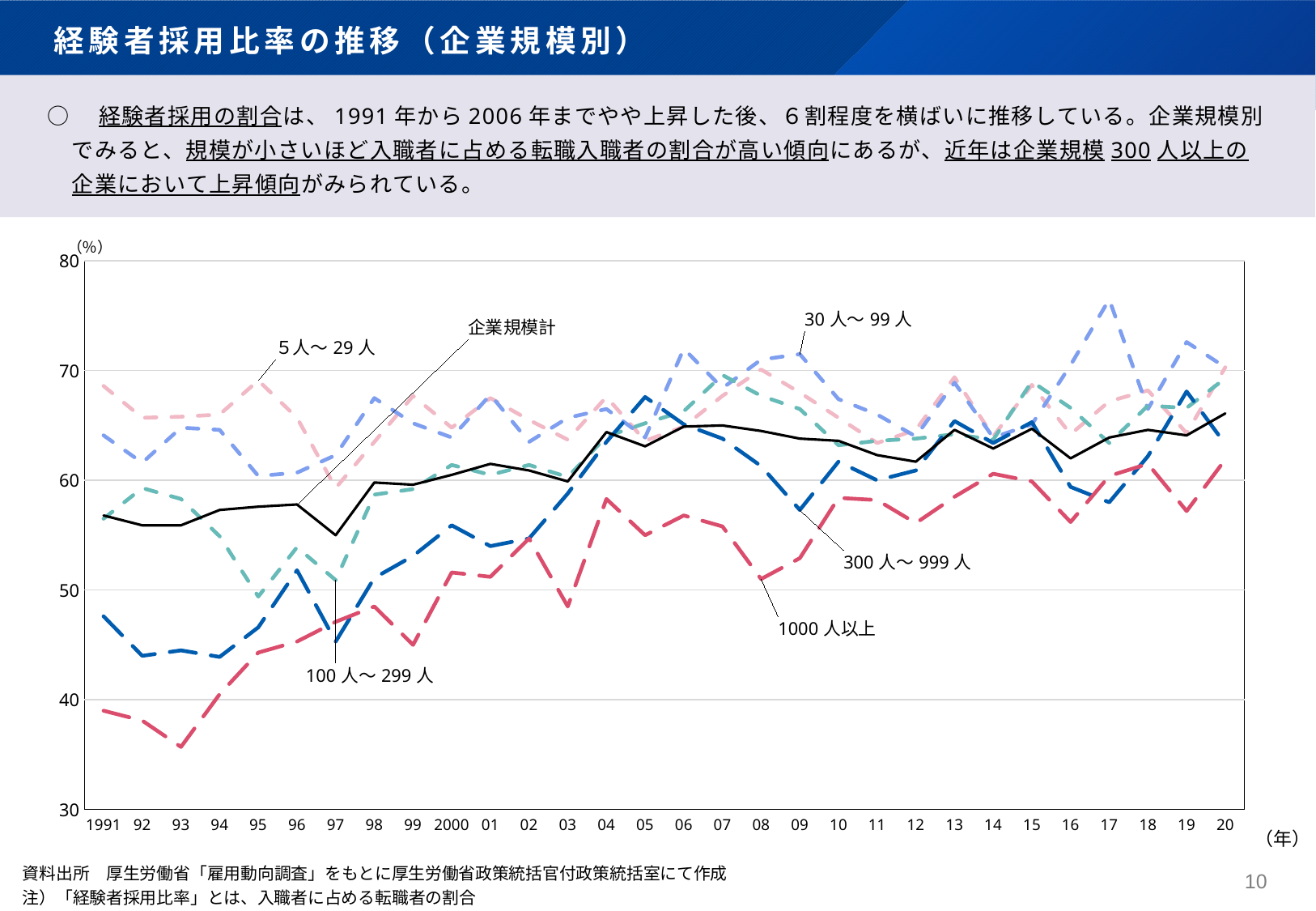
What kind of chart is shown on the slide? line chart Is the value for 30人〜99人 in 2017 greater or less than 70? greater Is the value for 300人〜999人 in 1991 greater or less than 50? less In 1993, which is larger: the value for 5人〜29人 or the value for 1000人以上? 5人〜29人 Which series has the highest value in 2017? 30人〜99人 What is the title of the chart on the slide? 経験者採用比率の推移（企業規模別） Is the value for 企業規模計 in 1997 greater or less than 60? less Which series has the lowest value in 1993? 1000人以上 How many years are plotted along the x axis of the chart? 30 How many series are labelled on the chart? 6 What unit is shown on the y axis of the chart? %